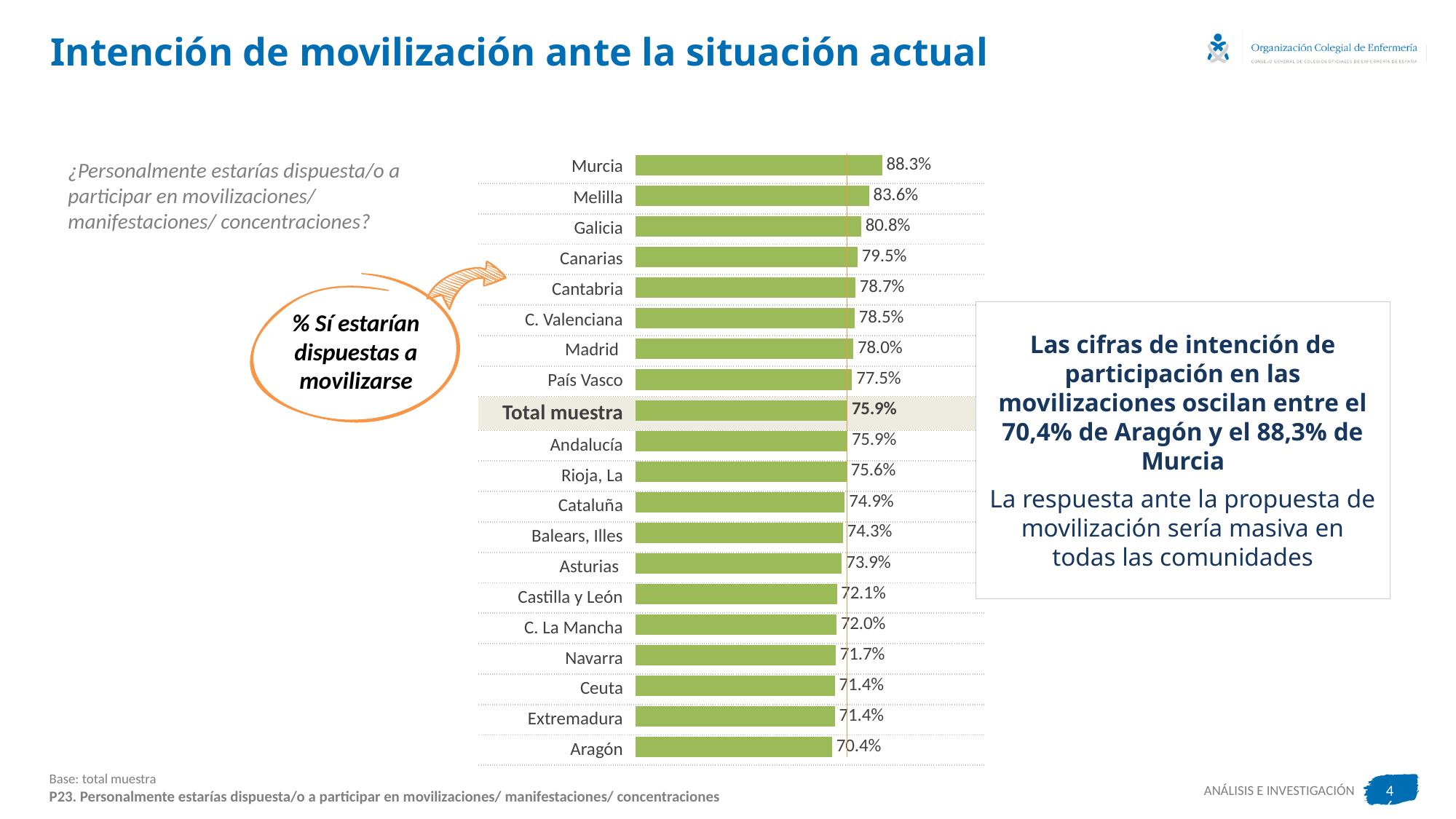
Which has a larger value, Melilla or Canarias? Melilla What is the difference between the values for Murcia and Aragón? 17.9% What is the difference between the values for Galicia and Madrid? 2.8% What is the value for Total muestra? 75.9% Which category has the lowest value? Aragón Which has a larger value, Asturias or Navarra? Asturias What colour are the bars in the chart? Green Which category has the highest value? Murcia What is the value for Cataluña? 74.9% What is the value for Murcia? 88.3% What kind of chart is shown on the slide? Bar chart How many categories are shown in the chart? 20